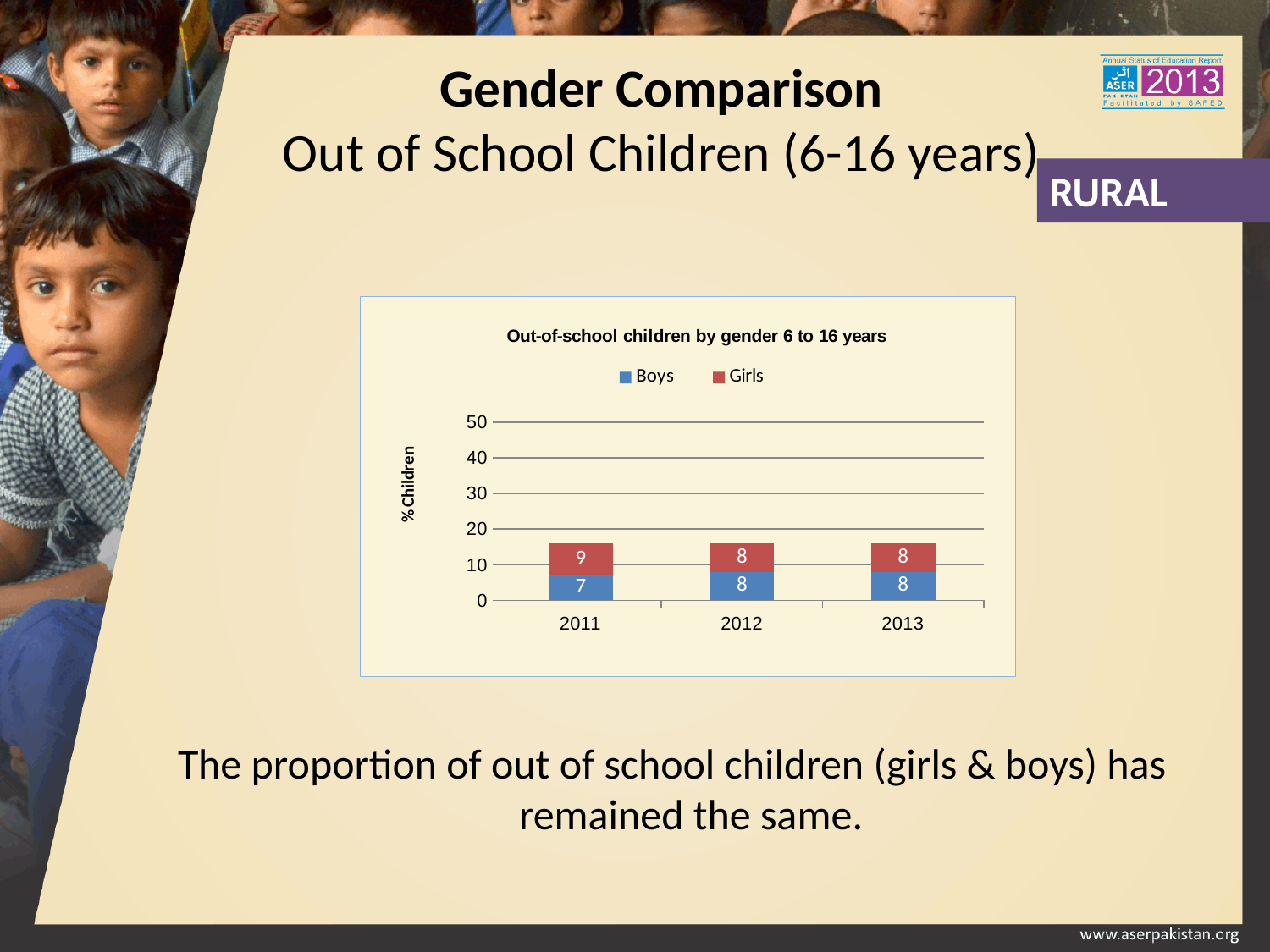
How many series does the legend list? 2 What is the value for Girls in 2012? 8 What is the value for Girls in 2011? 9 What is the total of the stacked bar for 2013? 16 In 2011, which is larger, the Boys value or the Girls value? Girls What kind of chart is shown? Stacked bar chart What is the total of the stacked bar for 2011? 16 How many years are shown on the x axis? 3 What is the value for Boys in 2011? 7 What is the difference between the Girls and Boys values in 2011? 2 What is the title of the chart? Out-of-school children by gender 6 to 16 years What is the value for Boys in 2013? 8